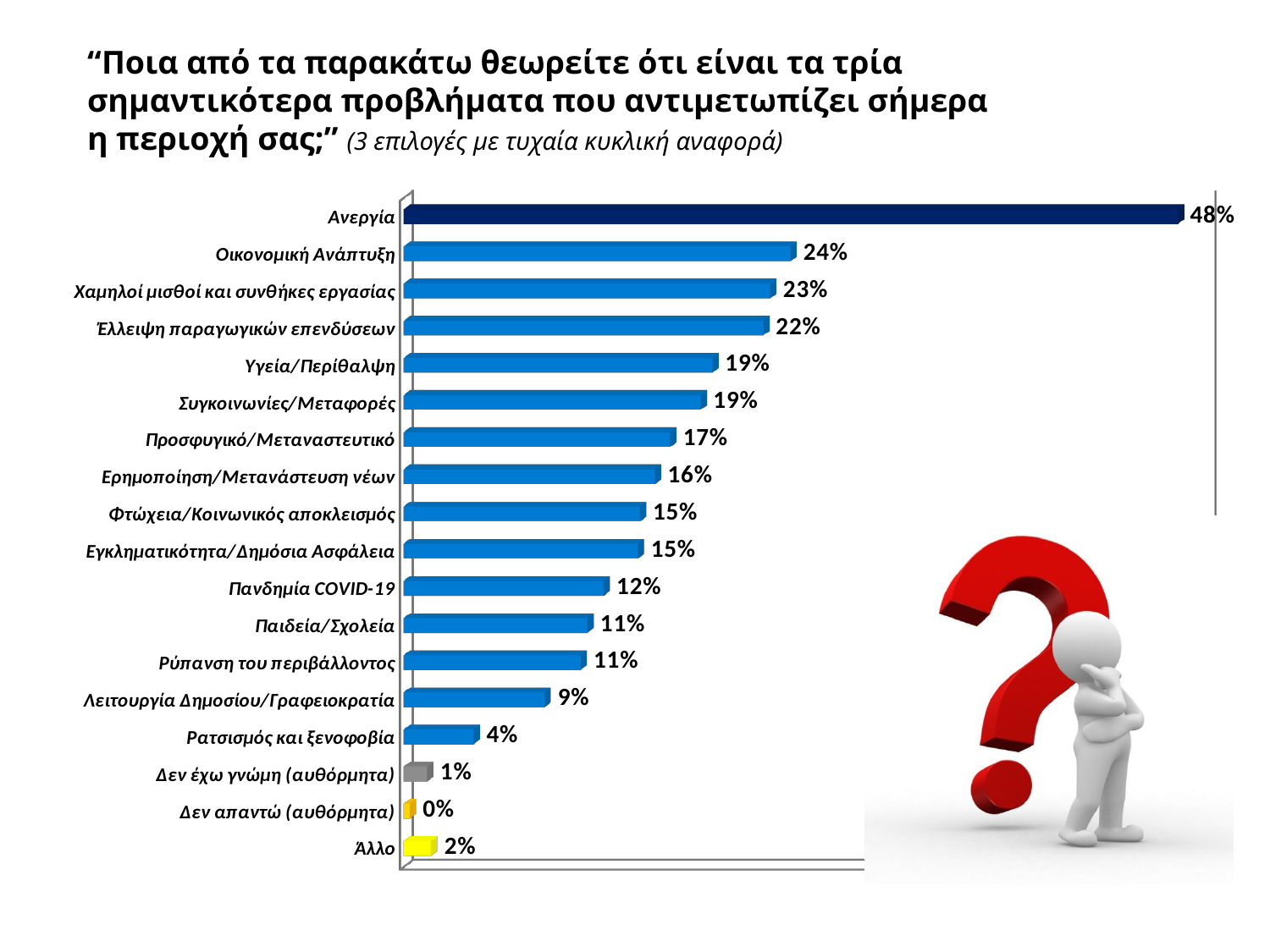
What is the value for Ρατσισμός και ξενοφοβία? 4% What is the difference between the values for Ανεργία and Οικονομική Ανάπτυξη? 24% What colour is the bar for Άλλο? Yellow What is the value for Ανεργία? 48% How many categories are shown in the chart? 18 What kind of chart is shown on the slide? Bar chart What is the value for Λειτουργία Δημοσίου/Γραφειοκρατία? 9% Which is larger, the value for Υγεία/Περίθαλψη or the value for Προσφυγικό/Μεταναστευτικό? Υγεία/Περίθαλψη Which category has the lowest value? Δεν απαντώ (αυθόρμητα) What is the value for Πανδημία COVID-19? 12% Which category has the highest value? Ανεργία What is the difference between the values for Χαμηλοί μισθοί και συνθήκες εργασίας and Έλλειψη παραγωγικών επενδύσεων? 1%